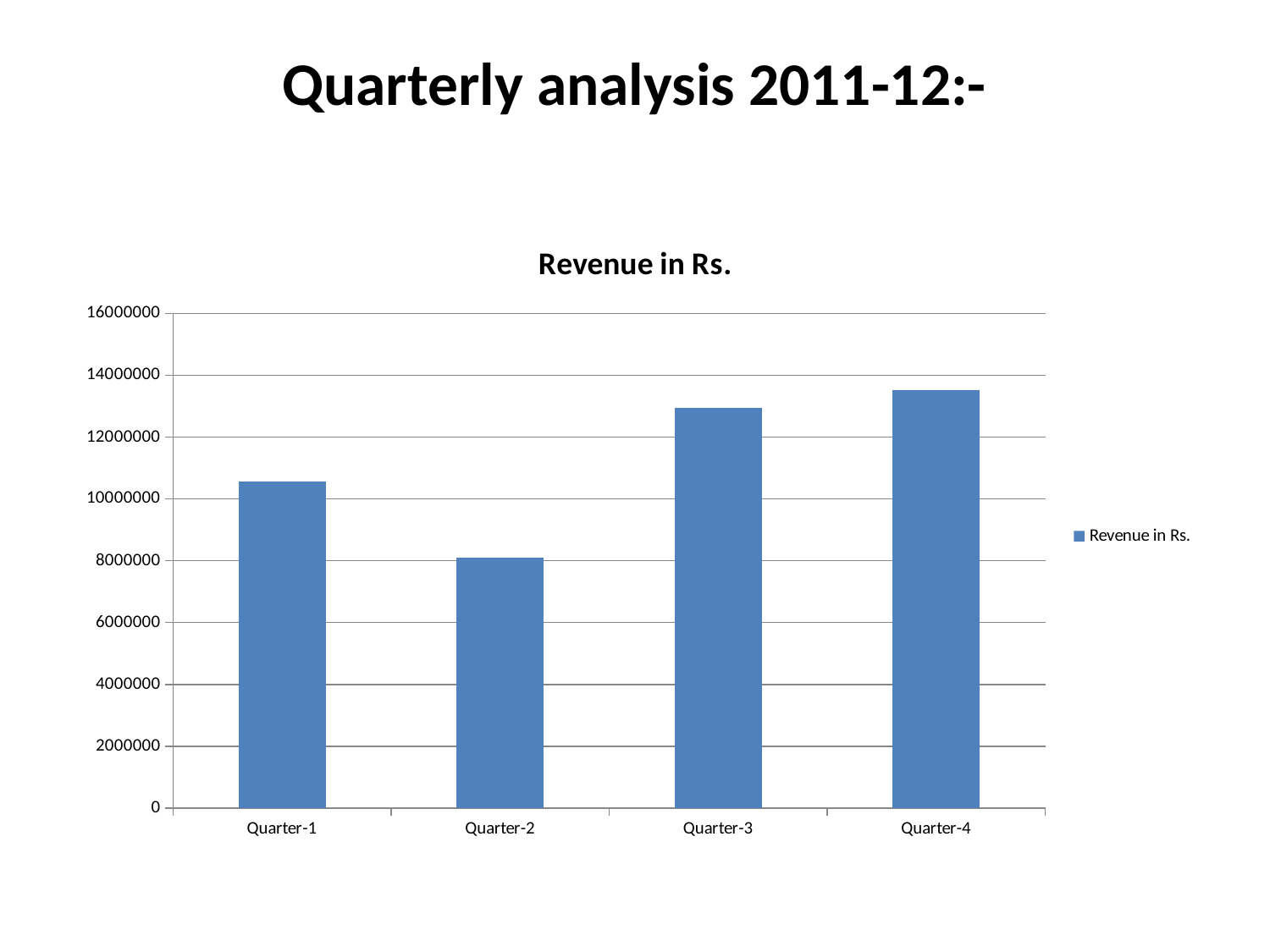
Which quarter has the highest revenue? Quarter-4 Is the revenue for Quarter-4 greater or less than 14000000? less Which has higher revenue, Quarter-1 or Quarter-3? Quarter-3 How many quarters are plotted on the chart? 4 Is the revenue for Quarter-3 greater or less than 12000000? greater Which quarter has the lowest revenue? Quarter-2 Is the revenue for Quarter-2 greater or less than 10000000? less How many series does the legend list? 1 What kind of chart is shown on the slide? bar chart What is the title of the chart? Revenue in Rs. Does revenue rise or fall from Quarter-2 to Quarter-4? rise